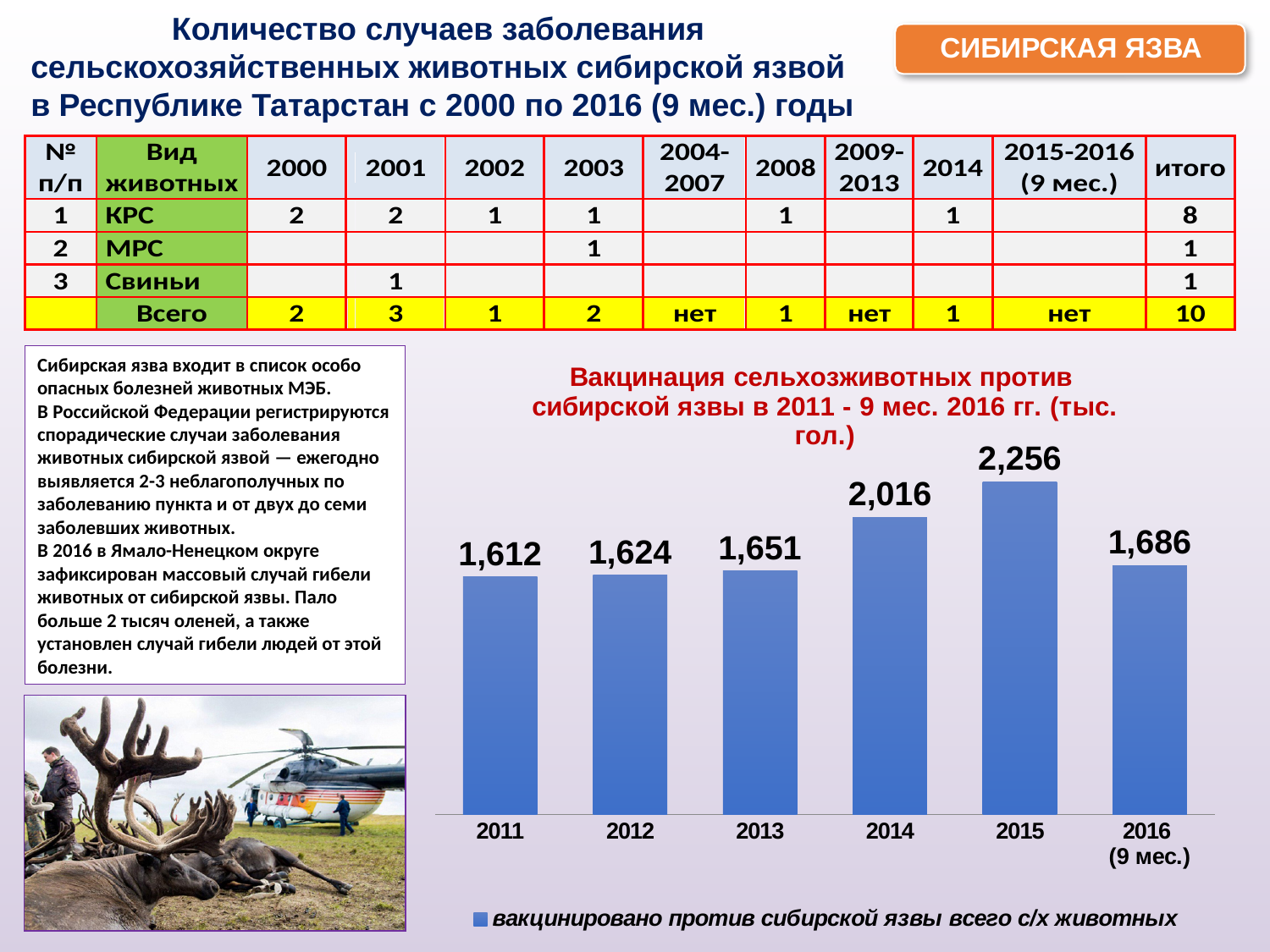
Do the values in the vaccination chart rise or fall from 2011 to 2015? rise What is the value for 2011 in the vaccination chart? 1,612 Which is larger in the vaccination chart, the value for 2016 (9 мес.) or the value for 2013? 2016 (9 мес.) How many series does the legend of the vaccination chart list? 1 How many years (categories) are shown in the vaccination chart? 6 Which year has the highest value in the vaccination chart? 2015 What is the difference between the values for 2015 and 2014 in the vaccination chart? 240 What type of chart is the vaccination chart? bar chart What is the value for 2016 (9 мес.) in the vaccination chart? 1,686 What is the value for 2014 in the vaccination chart? 2,016 Which year has the lowest value in the vaccination chart? 2011 What is the difference between the values for 2013 and 2012 in the vaccination chart? 27